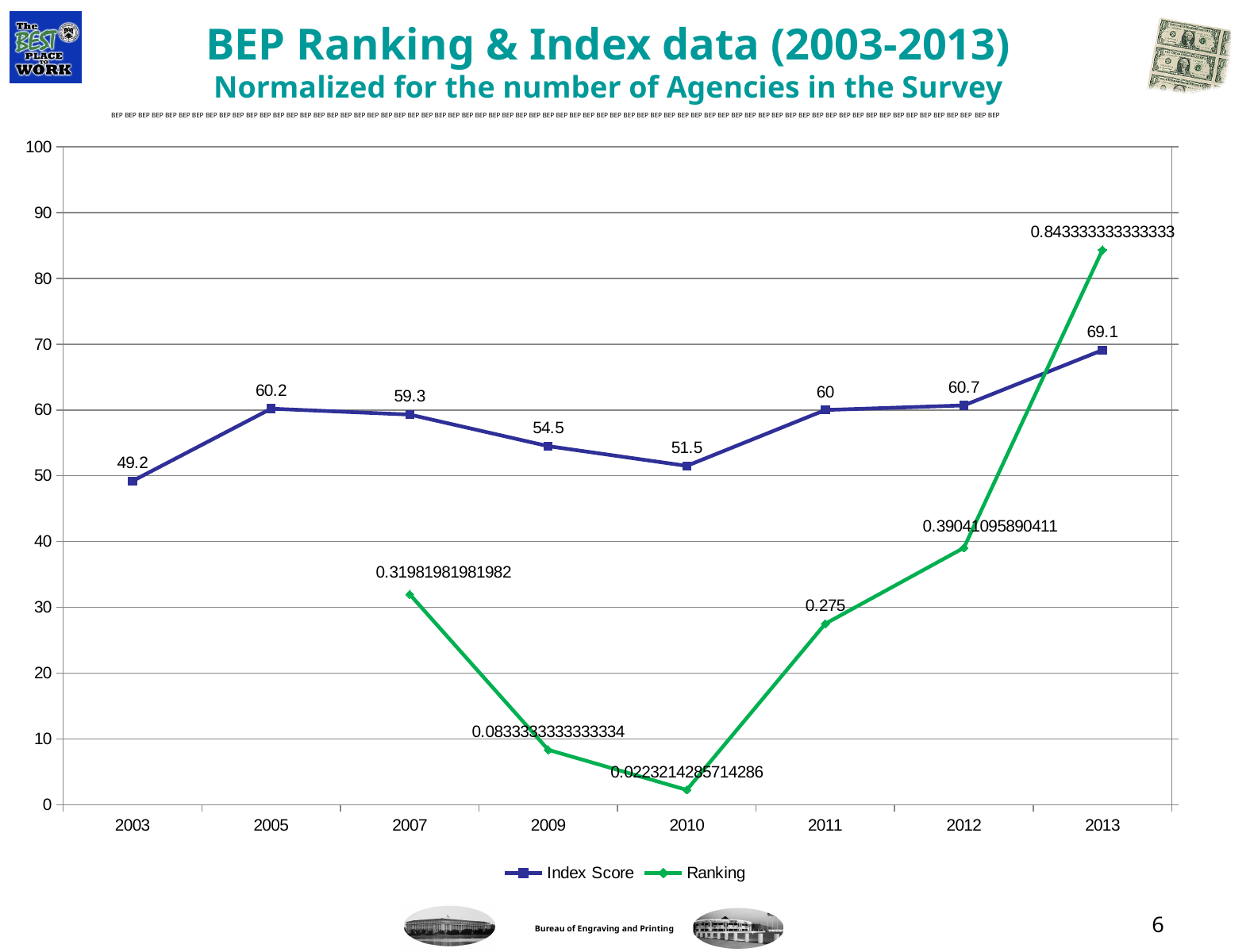
What type of chart is shown on the slide? line chart In which year is the Index Score lowest? 2003 How many series does the legend list? 2 What is the Ranking value labelled for 2011? 0.275 What is the Index Score for 2003? 49.2 What is the difference between the Index Score in 2013 and in 2003? 19.9 What is the Ranking value labelled for 2013? 0.843333333333333 Which is larger, the Index Score for 2005 or for 2007? 2005 How many years are shown on the x axis? 8 Does the Index Score rise or fall from 2010 to 2013? rise What is the Index Score for 2013? 69.1 In which year is the Index Score highest? 2013